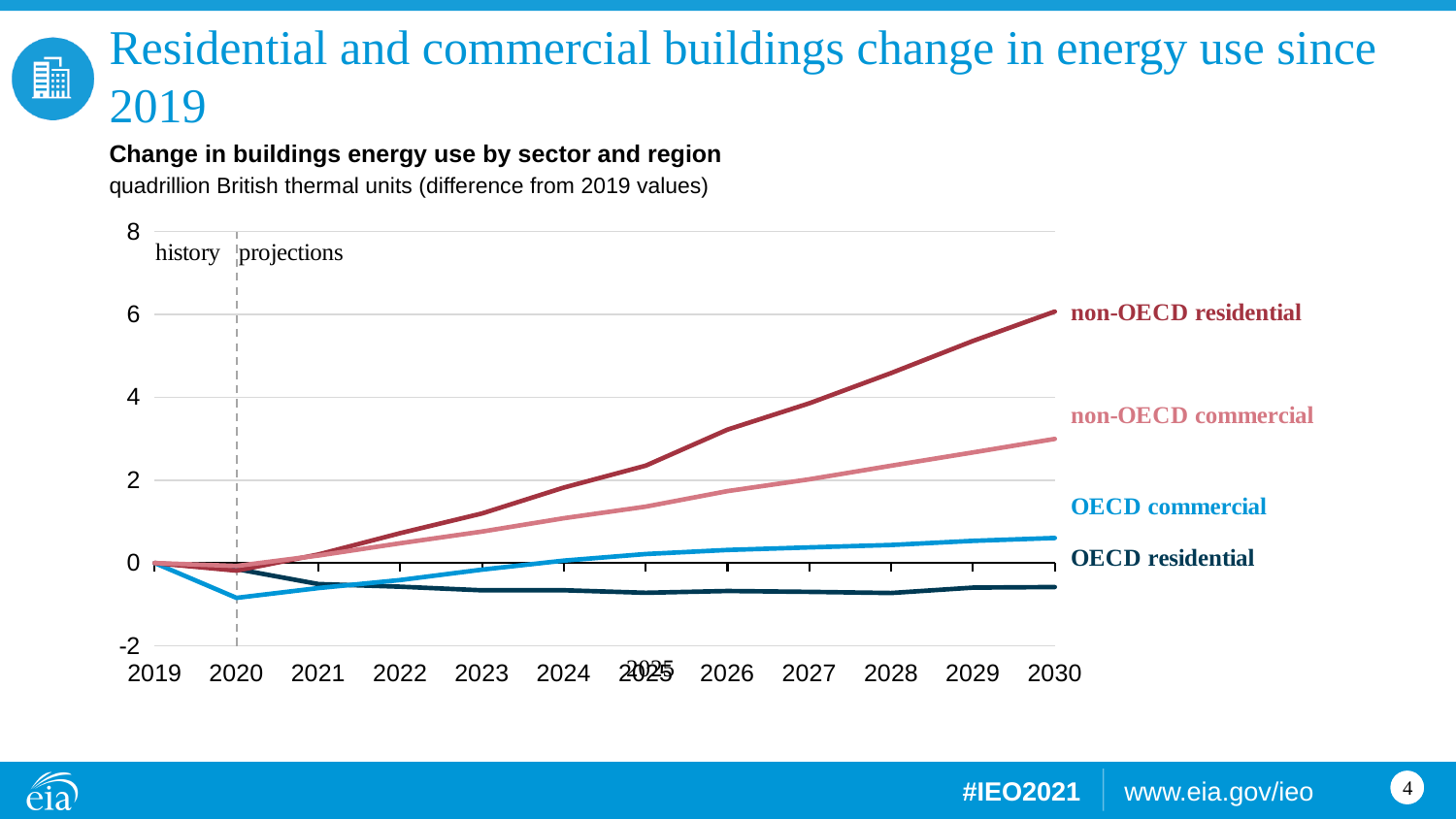
Is the value for non-OECD residential in 2030 greater or less than 4? greater How many years are labeled along the x axis? 12 Is the value for OECD residential in 2030 greater or less than 0? less Is the value for non-OECD commercial in 2030 greater or less than 2? greater Which series has the highest value in 2030? non-OECD residential What unit is given in the chart subtitle? quadrillion British thermal units (difference from 2019 values) What kind of chart is shown on the slide? line chart In 2030, which is larger: non-OECD commercial or OECD commercial? non-OECD commercial How many series are plotted on the chart? 4 Which series has the lowest value in 2030? OECD residential Which series has the lowest value in 2020? OECD commercial Does the non-OECD residential series rise or fall from 2020 to 2030? rise